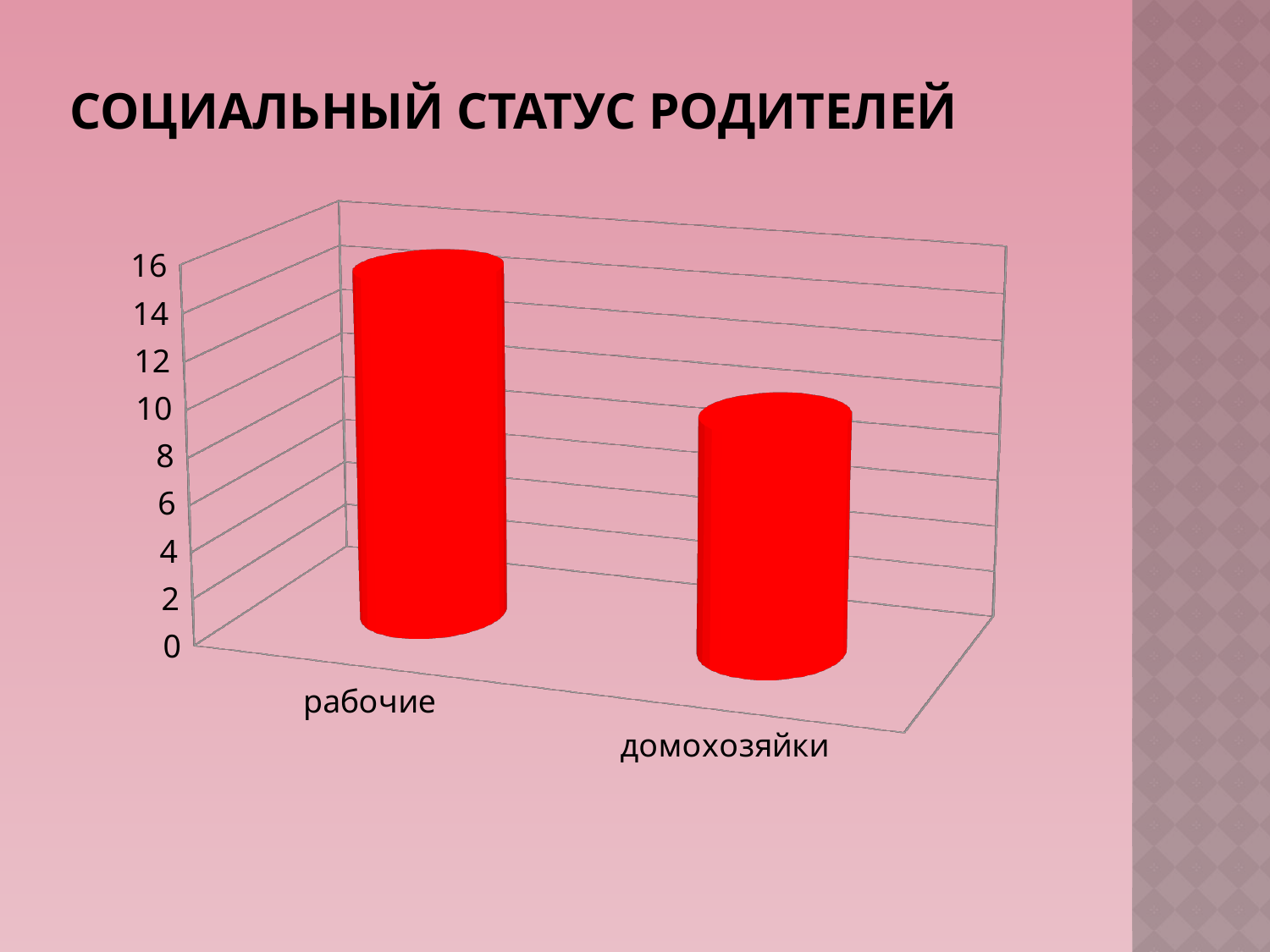
What is the title of the slide containing the chart? СОЦИАЛЬНЫЙ СТАТУС РОДИТЕЛЕЙ Is the value for рабочие greater or less than 12? greater Which is larger, the value for рабочие or the value for домохозяйки? рабочие Is the value for рабочие greater or less than 8? greater What kind of chart is shown on the slide? bar chart Is the value for домохозяйки greater or less than 14? less How many categories are shown on the x axis of the chart? 2 Which category has the lowest value in the chart? домохозяйки What colour are the bars in the chart? red What is the highest value shown on the vertical axis of the chart? 16 Which category has the highest value in the chart? рабочие